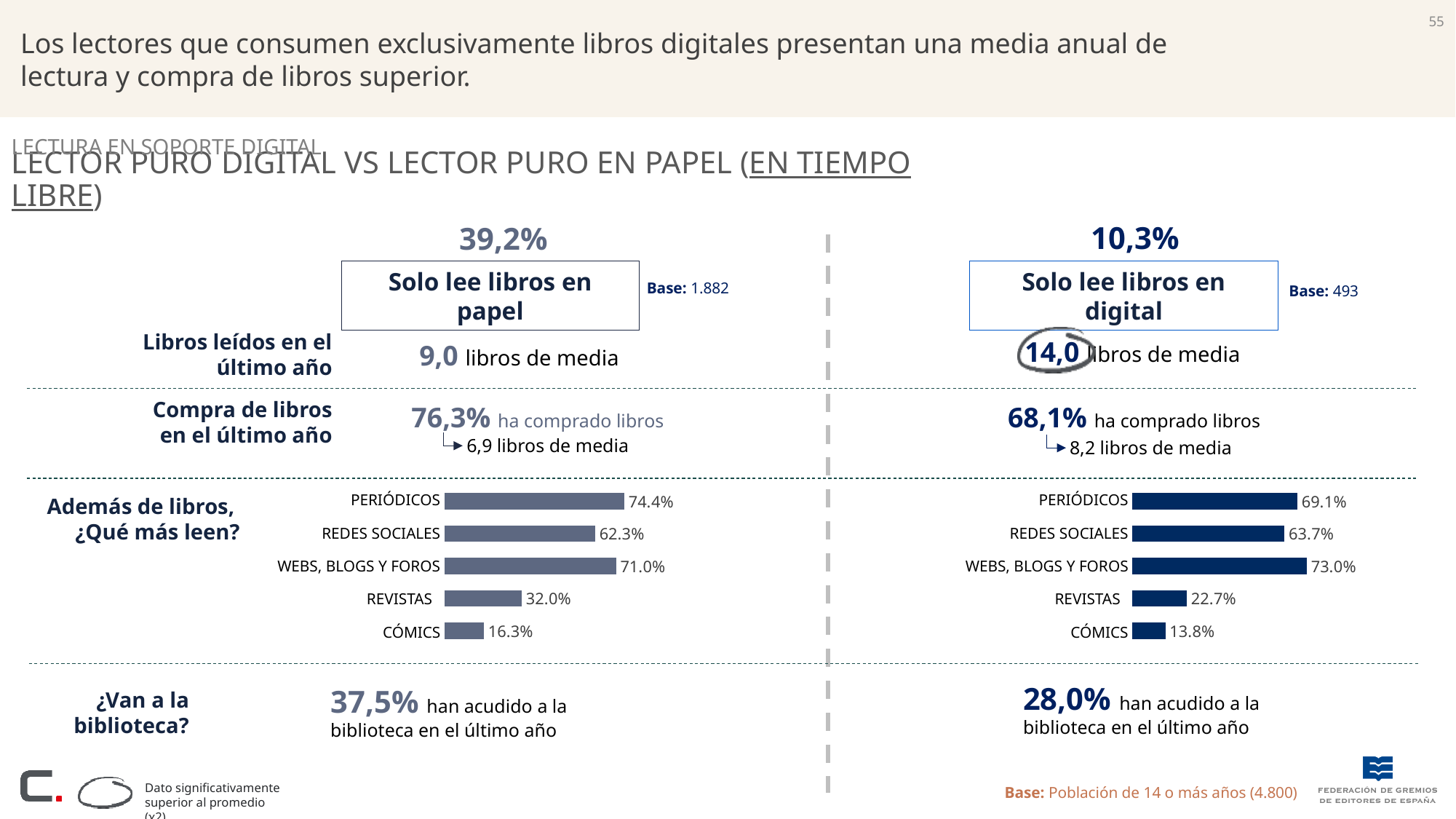
How many categories are shown in the 'Solo lee libros en papel' bar chart on the left? 5 In the 'Solo lee libros en digital' chart on the right, which category has the lowest value? CÓMICS In the 'Solo lee libros en digital' chart on the right, what is the difference between REDES SOCIALES and CÓMICS? 49.9% In the 'Solo lee libros en digital' chart on the right, which category has the highest value? WEBS, BLOGS Y FOROS Which is larger: REVISTAS in the left 'Solo lee libros en papel' chart or REVISTAS in the right 'Solo lee libros en digital' chart? Left (papel), 32.0% In the 'Solo lee libros en digital' chart on the right, what is the value for REVISTAS? 22.7% In the 'Solo lee libros en digital' chart on the right, what is the value for WEBS, BLOGS Y FOROS? 73.0% What type of chart is used to show 'Además de libros, ¿Qué más leen?' on the slide? Bar chart In the 'Solo lee libros en papel' chart on the left, what is the value for CÓMICS? 16.3% In the 'Solo lee libros en papel' chart on the left, what is the value for PERIÓDICOS? 74.4% In the 'Solo lee libros en papel' chart on the left, what is the difference between PERIÓDICOS and REVISTAS? 42.4% In the 'Solo lee libros en papel' chart on the left, which category has the highest value? PERIÓDICOS